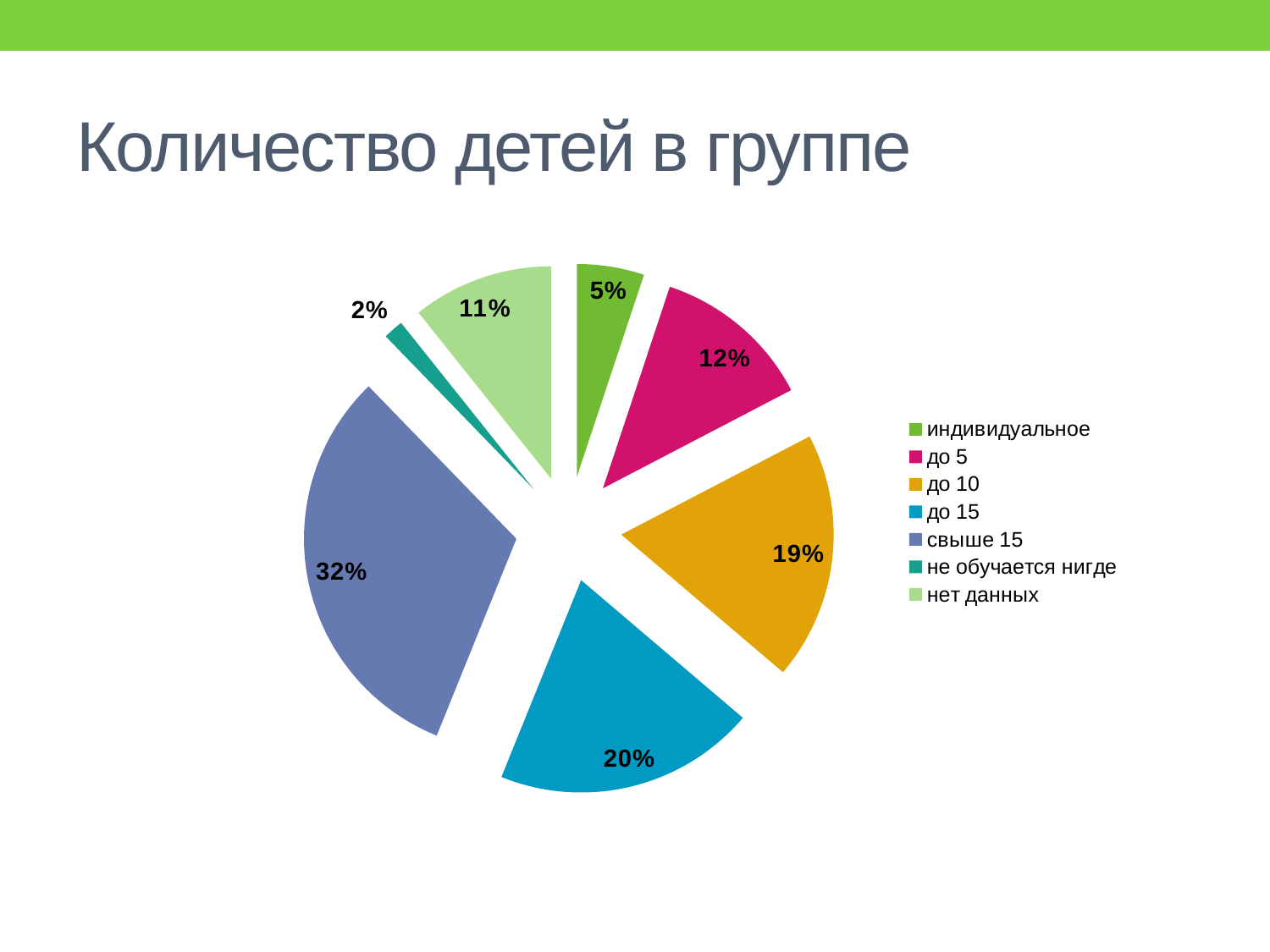
Which is larger, the share for "нет данных" or the share for "до 5"? до 5 What kind of chart is shown on the slide? pie chart What share of the pie does "свыше 15" have? 32% What share of the pie does "не обучается нигде" have? 2% Which category has the largest slice? свыше 15 What share of the pie does "до 10" have? 19% Which category has the smallest slice? не обучается нигде What is the difference between the shares of "свыше 15" and "до 5"? 20% How many categories does the legend list? 7 What is the title of the chart? Количество детей в группе